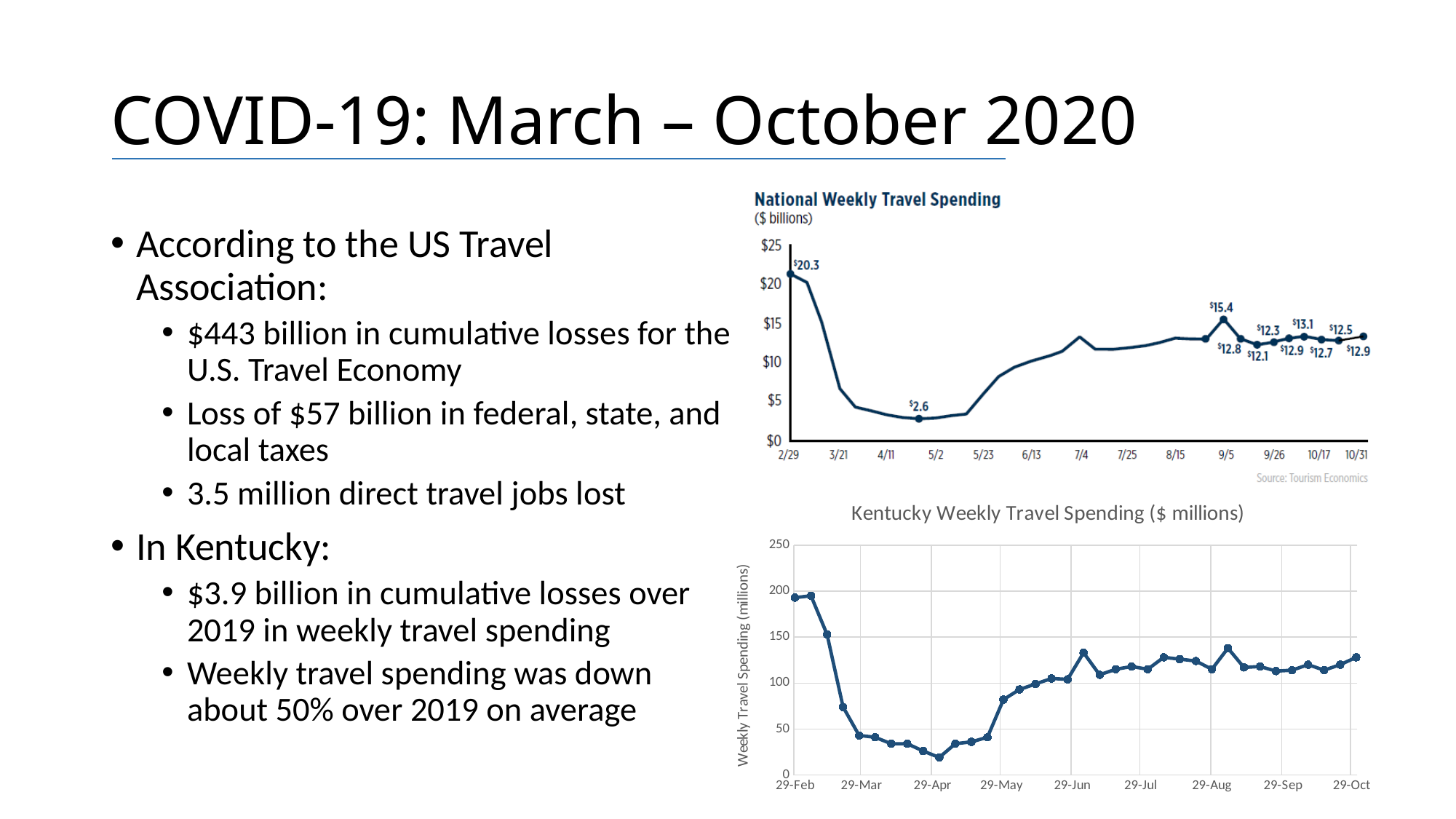
In the Kentucky Weekly Travel Spending chart, which is larger: the value at 29-Feb or the value at 29-Oct? 29-Feb In the Kentucky Weekly Travel Spending chart, is the value at 29-Feb greater or less than 150? greater In the National Weekly Travel Spending chart, what is the lowest labeled value? $2.6 In the National Weekly Travel Spending chart, what is the value labeled at 2/29? $20.3 In the Kentucky Weekly Travel Spending chart, is the value at 29-Apr greater or less than 50? less In the Kentucky Weekly Travel Spending chart, do values rise or fall between 29-Feb and 29-Apr? fall In the National Weekly Travel Spending chart, what is the difference between the first labeled value ($20.3) and the lowest labeled value ($2.6)? $17.7 In the National Weekly Travel Spending chart, what is the value labeled at the peak near 9/5? $15.4 What is the source cited under the National Weekly Travel Spending chart? Tourism Economics What kind of chart is the Kentucky Weekly Travel Spending chart? line chart In the National Weekly Travel Spending chart, what is the highest value shown? $20.3 What kind of chart is the National Weekly Travel Spending chart? line chart